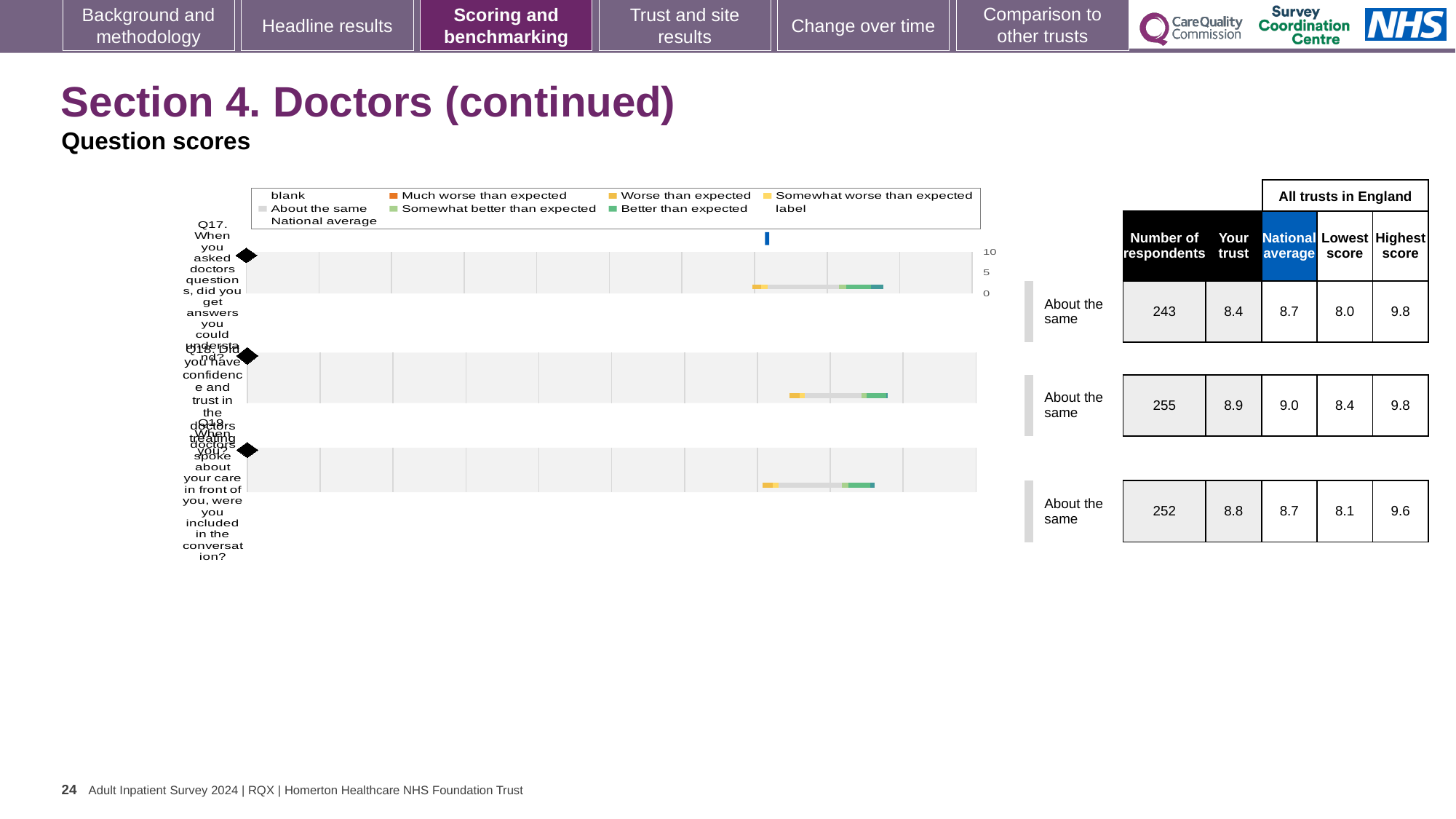
How many questions (Q17, Q18, Q19) are plotted as separate bars on the slide? 3 What kind of chart is used to show the question scores for Q17, Q18 and Q19? bar chart In the table beside the charts, which question has the highest 'Your trust' score? Q18 In the table beside the charts, how many respondents answered Q17? 243 How many entries does the chart legend list? 9 In the table beside the charts, what is the 'Your trust' score for Q18? 8.9 In the table beside the charts, what is the national average for Q19? 8.7 Which legend entry is shown in light grey? About the same What benchmark category is shown next to the Q17 bar? About the same In the table beside the charts, is the 'Your trust' score for Q17 larger or smaller than the national average for Q17? smaller In the table beside the charts, what is the difference between the highest score and the lowest score for Q19? 1.5 Which legend entry is shown in orange? Much worse than expected